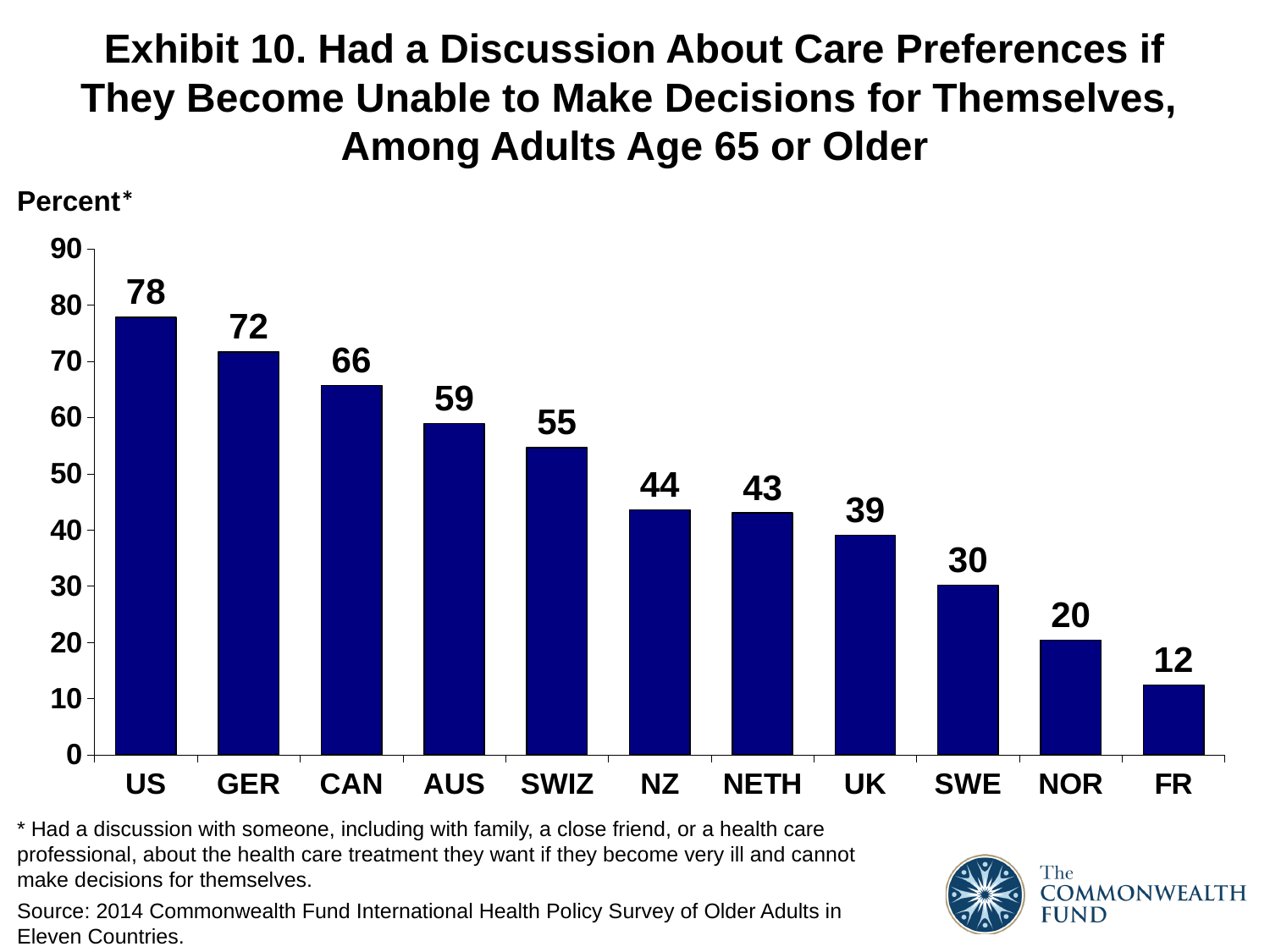
Is the value for SWE greater or less than 40? less Which is larger, the value for AUS or the value for UK? AUS How many countries are shown in the chart? 11 What kind of chart is this? bar chart What is the value for SWIZ? 55 What is the value for NOR? 20 Which country has the highest value? US What is the difference between the values for GER and CAN? 6 Do the values rise or fall from left to right along the x axis? fall Which country has the lowest value? FR What is the difference between the values for US and FR? 66 What is the value for the US? 78